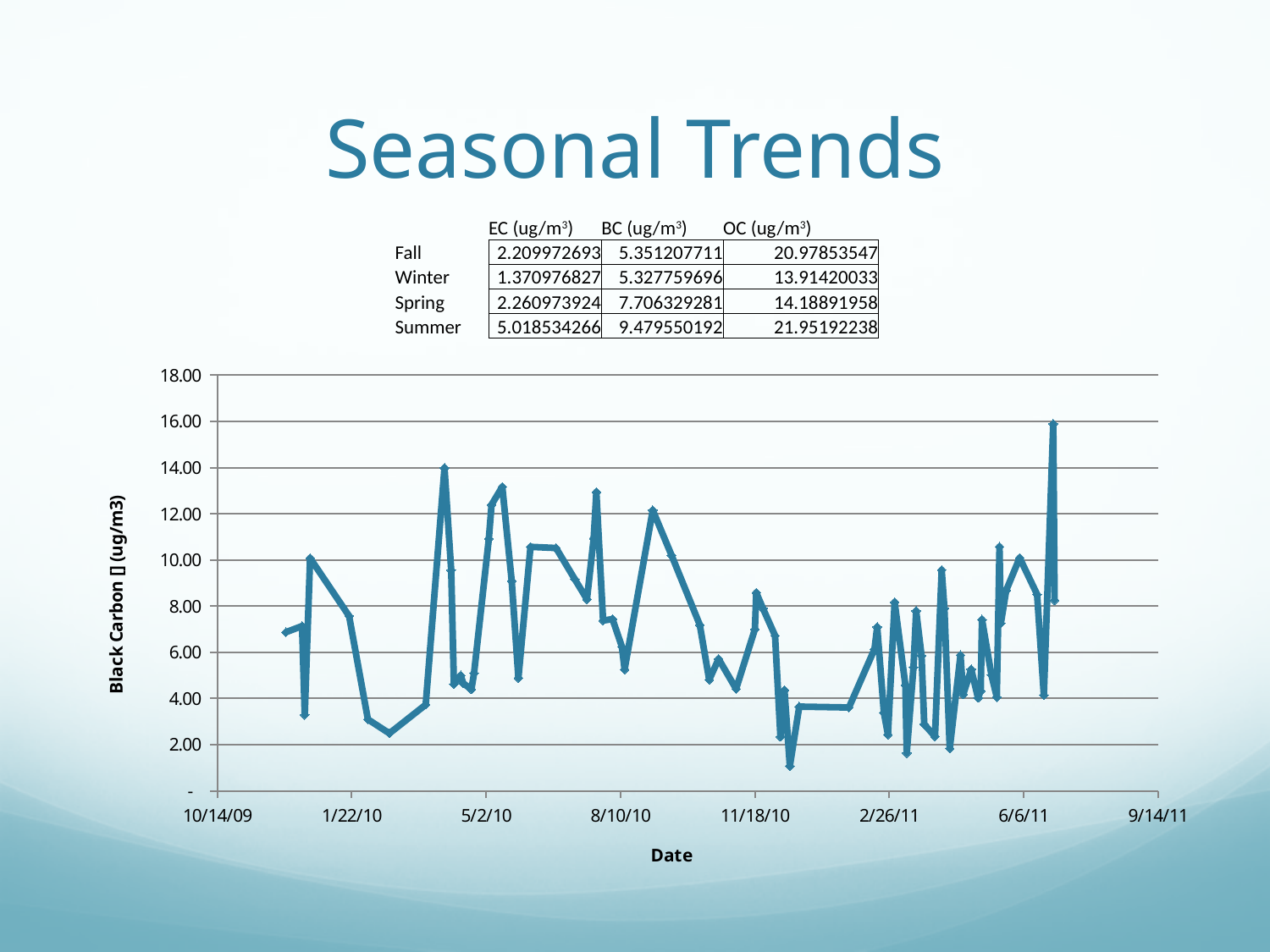
Is the black carbon value at the 5/2/10 tick greater or less than 8.00? greater What type of chart is shown on the slide? line chart Is the black carbon value at the 6/6/11 tick greater or less than 8.00? greater What is the label of the x-axis of the chart? Date Which x-axis tick label comes last on the chart? 9/14/11 Is the highest peak of the black carbon line greater or less than 14.00? greater Does the highest peak of the line occur near the beginning or near the end of the date range? near the end What is the label of the y-axis of the chart? Black Carbon [] (ug/m3) What is the highest value shown on the y-axis of the chart? 18.00 How many data series are plotted in the chart? 1